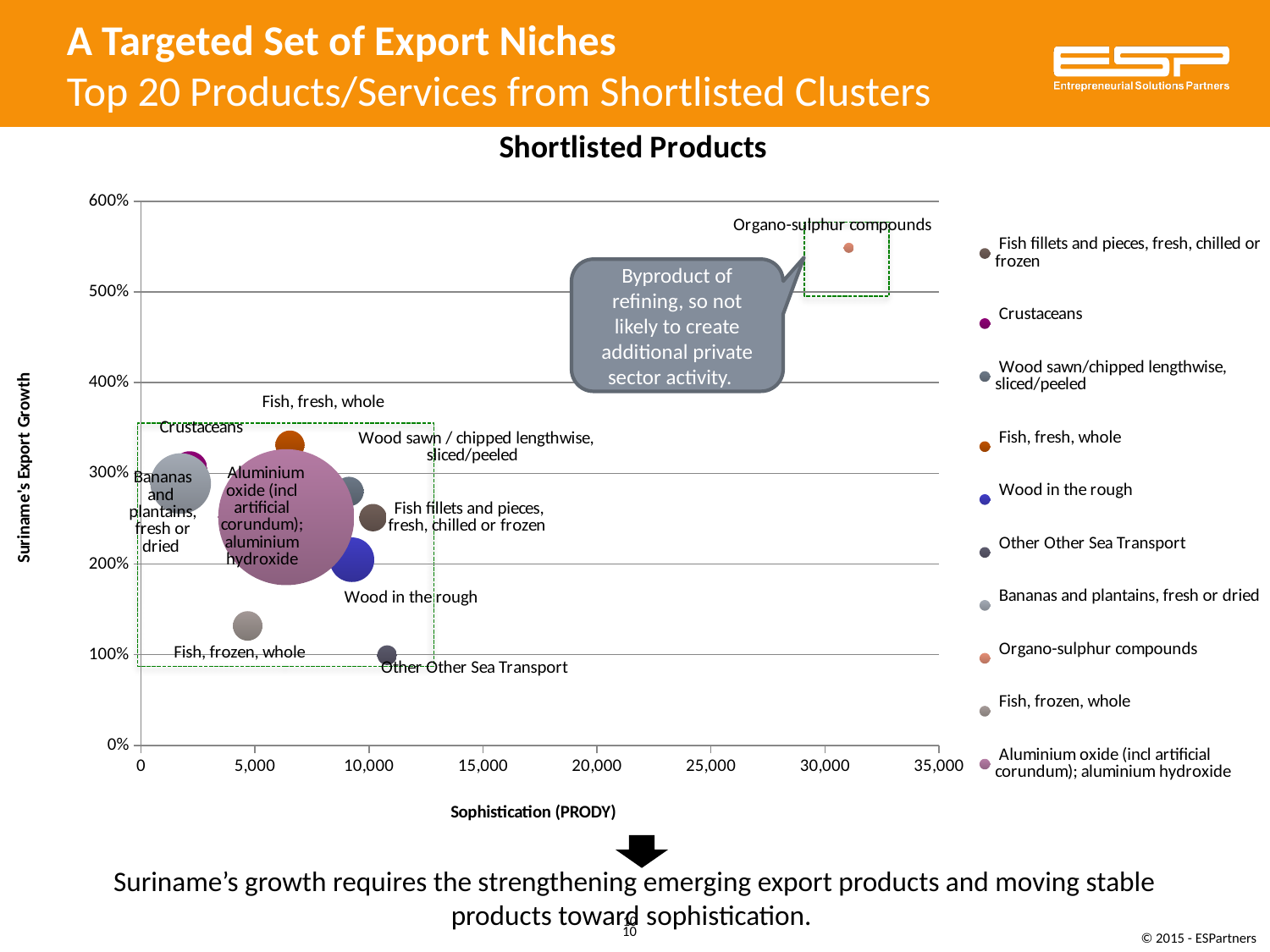
Is the Sophistication (PRODY) for Organo-sulphur compounds greater or less than 25,000? greater Which product has the lowest Suriname's Export Growth in the Shortlisted Products chart? Other Other Sea Transport Which has higher export growth, Fish, fresh, whole or Wood in the rough? Fish, fresh, whole How many products does the legend of the Shortlisted Products chart list? 10 What is the label of the x axis of the Shortlisted Products chart? Sophistication (PRODY) Is the export growth for Organo-sulphur compounds greater or less than 500%? greater What kind of chart is shown on the slide? Bubble chart Is the Sophistication (PRODY) for Fish, frozen, whole greater or less than 10,000? less Which product has the highest Sophistication (PRODY) in the Shortlisted Products chart? Organo-sulphur compounds Which product has the highest Suriname's Export Growth in the Shortlisted Products chart? Organo-sulphur compounds